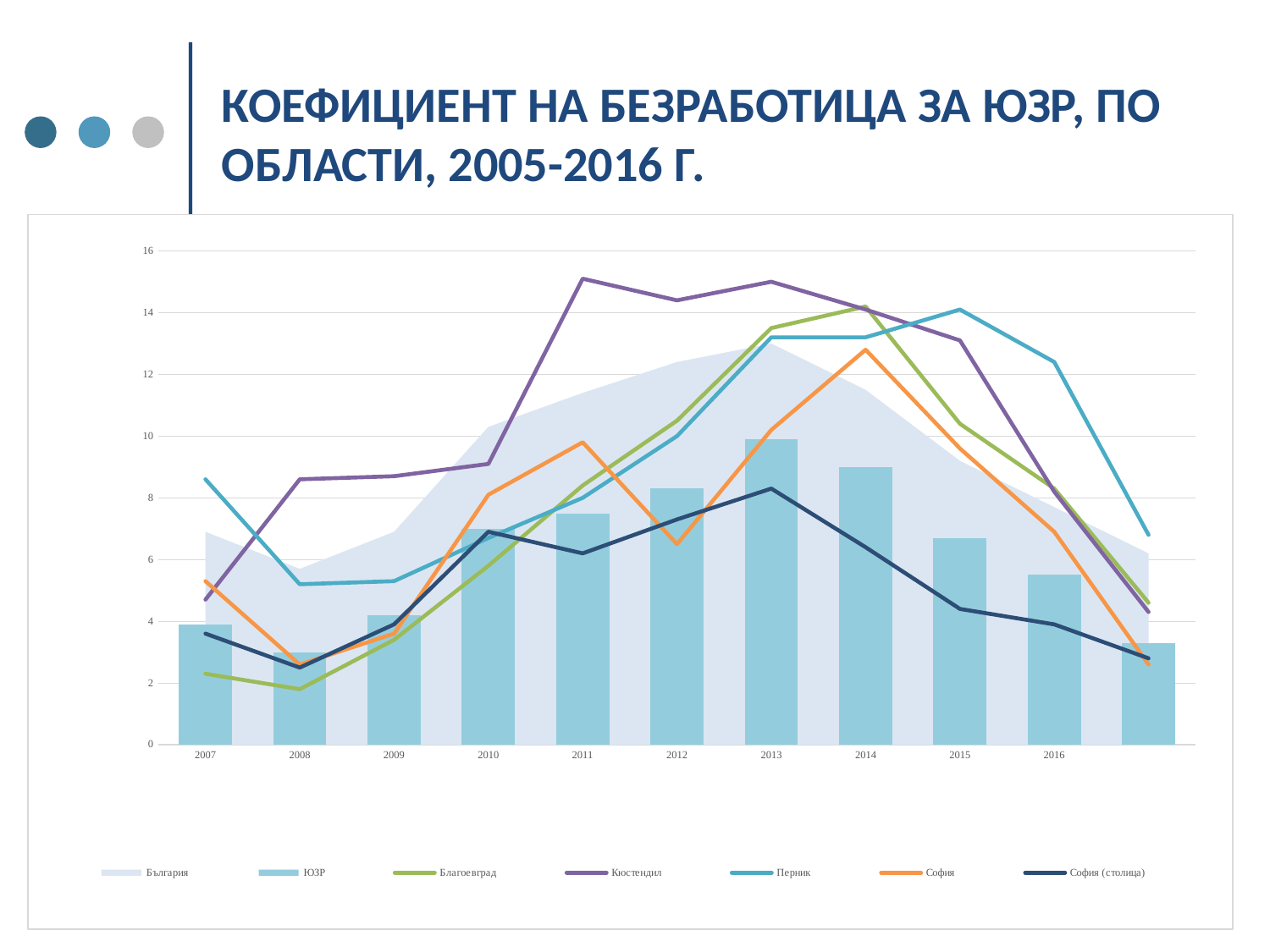
What kind of chart is shown on the slide? Combination area, bar and line chart Which series has the highest value in 2015? Перник In which year is the ЮЗР bar the lowest? 2008 Is the Благоевград value for 2008 greater or less than 4? less Is the ЮЗР value for 2013 greater or less than 8? greater Which is larger, the ЮЗР value for 2013 or for 2016? 2013 In which year is the ЮЗР bar the highest? 2013 How many series does the chart legend list? 7 Which series has the highest value in 2011? Кюстендил What is the title of the chart on the slide? КОЕФИЦИЕНТ НА БЕЗРАБОТИЦА ЗА ЮЗР, ПО ОБЛАСТИ, 2005-2016 Г. Do the ЮЗР bars rise or fall from 2013 to 2016? fall Is the Кюстендил value for 2011 greater or less than 14? greater